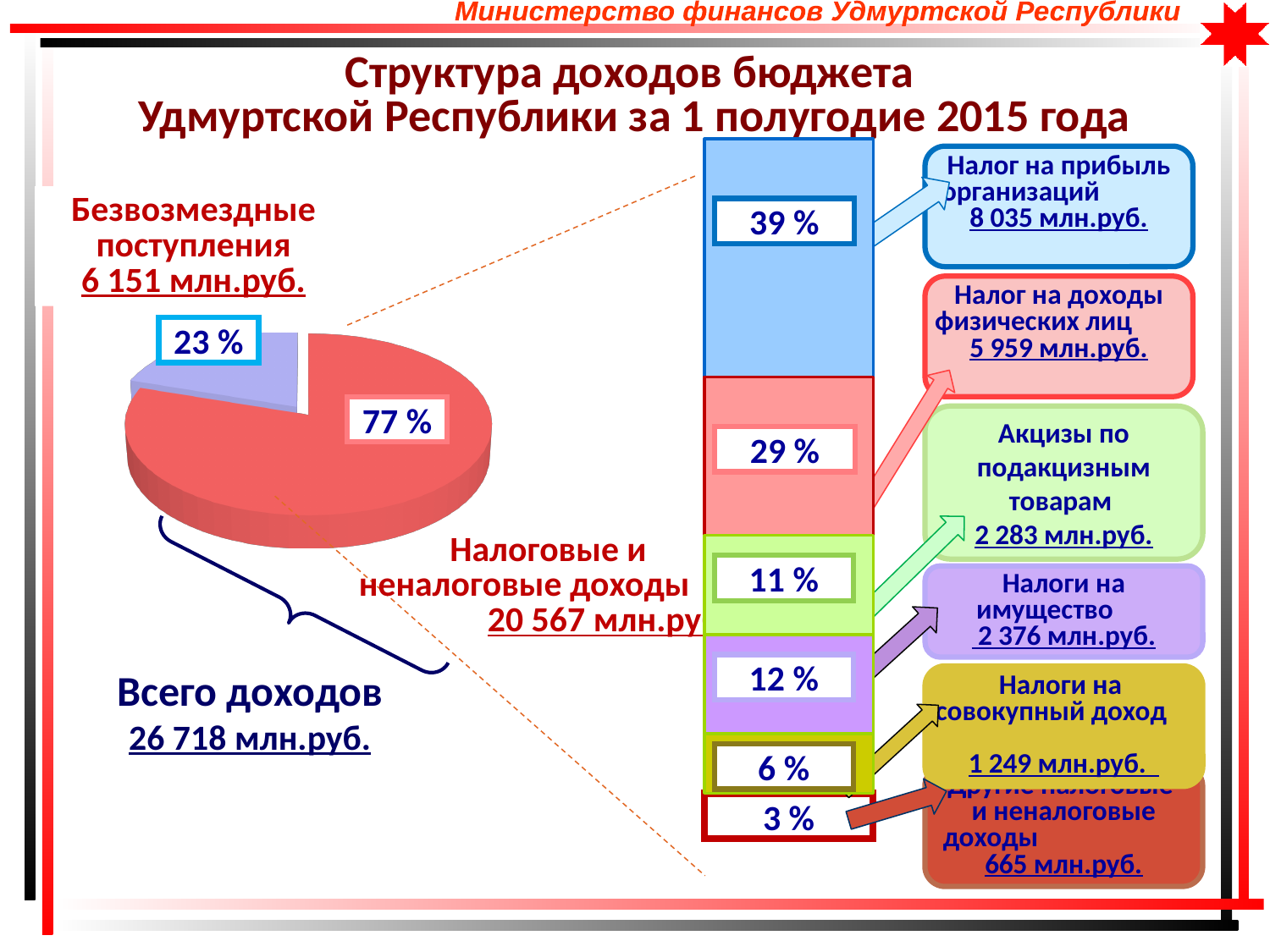
On the pie chart, what share of total revenue is 'Налоговые и неналоговые доходы'? 77 % On the pie chart, what share of total revenue is 'Безвозмездные поступления'? 23 % On the stacked bar, which segment has the smallest share? Другие налоговые и неналоговые доходы On the stacked bar, what is the amount for 'Налог на доходы физических лиц'? 5 959 млн.руб. What is the total revenue ('Всего доходов') shown on the slide? 26 718 млн.руб. On the stacked bar, which is larger: 'Акцизы по подакцизным товарам' or 'Налоги на имущество'? Налоги на имущество On the stacked bar, what is the difference in percentage points between 'Налог на прибыль организаций' and 'Налог на доходы физических лиц'? 10 What kind of chart is on the left side of the slide? pie chart How many segments does the stacked bar on the right contain? 6 What is the amount of 'Безвозмездные поступления' shown next to the pie chart? 6 151 млн.руб. On the stacked bar, what percentage is shown for 'Налог на прибыль организаций'? 39 % On the stacked bar, which segment has the largest share? Налог на прибыль организаций